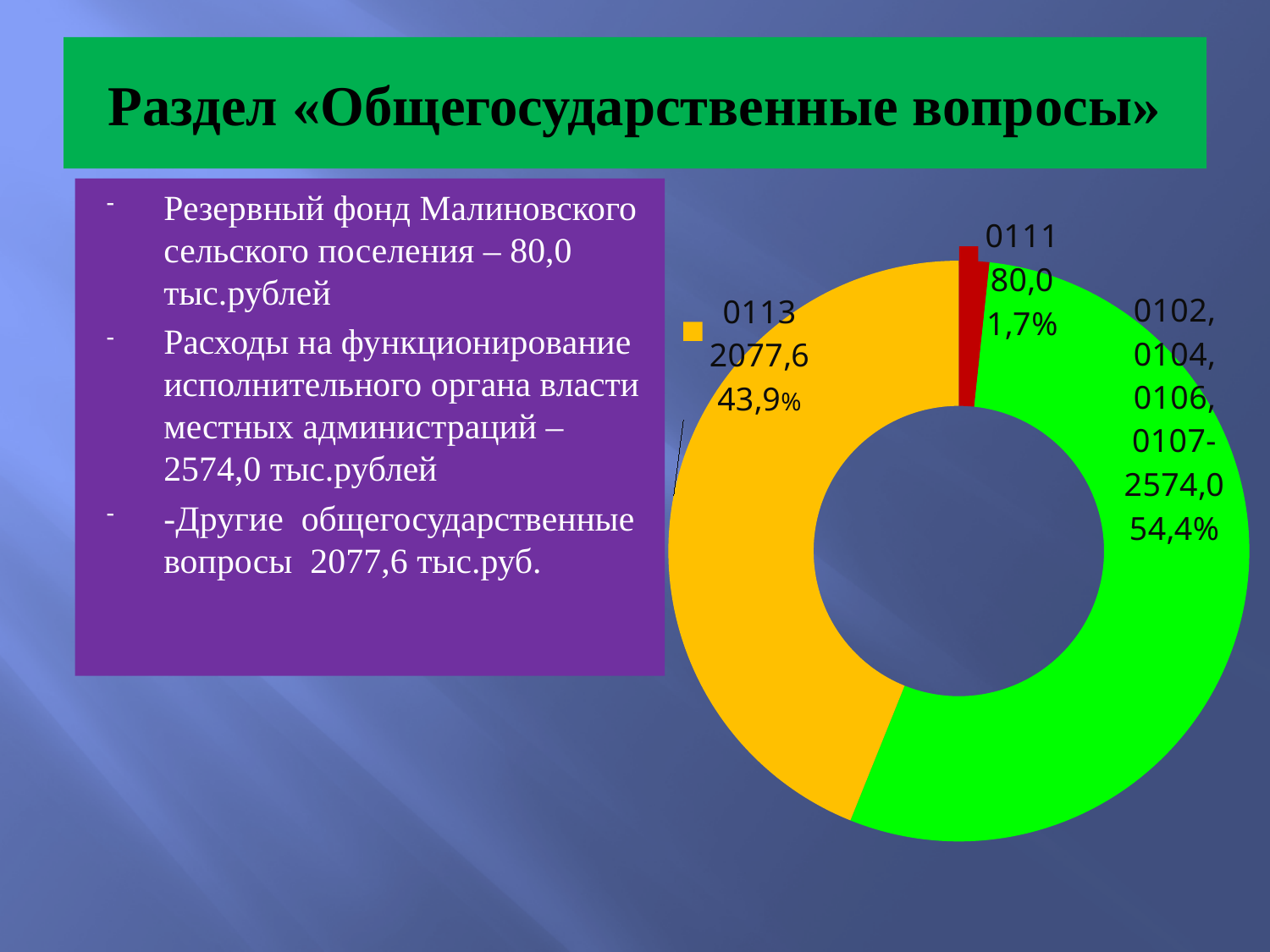
What share of the chart does slice 0113 represent? 43,9% What colour is the slice for 0113? orange (yellow-orange) What share of the chart does slice 0111 represent? 1,7% Which slice is the largest? 0102, 0104, 0106, 0107 What share of the chart does the slice labelled 0102, 0104, 0106, 0107 represent? 54,4% What value is shown for the slice labelled 0102, 0104, 0106, 0107? 2574,0 What value is shown for slice 0113? 2077,6 How many slices does the chart have? 3 What is the difference between the values of slice 0102, 0104, 0106, 0107 and slice 0113? 496,4 What value is shown for slice 0111? 80,0 Which slice is the smallest? 0111 What kind of chart is shown on the slide? doughnut chart